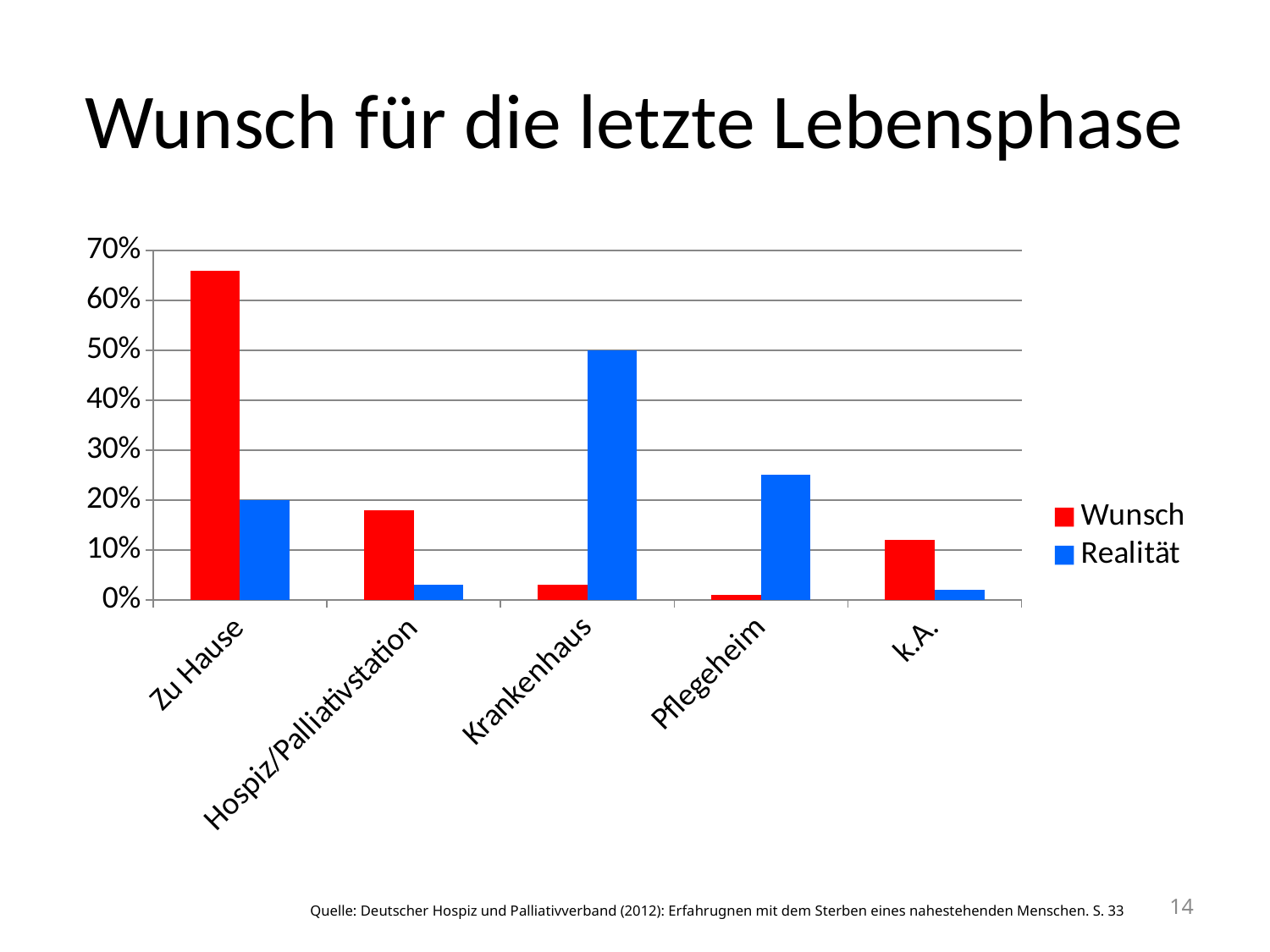
Is the Wunsch value for Zu Hause greater or less than 60%? greater What kind of chart is shown on the slide? bar chart Which category has the highest Wunsch value? Zu Hause What is the Realität value for Krankenhaus? 50% Is the Wunsch value for Hospiz/Palliativstation greater or less than 20%? less For Pflegeheim, which is larger, the Wunsch value or the Realität value? Realität How many categories are shown on the x axis? 5 Which category has the highest Realität value? Krankenhaus What is the Realität value for Zu Hause? 20% Which category has the lowest Wunsch value? Pflegeheim How many series does the legend list? 2 Which colour represents the Wunsch series? red